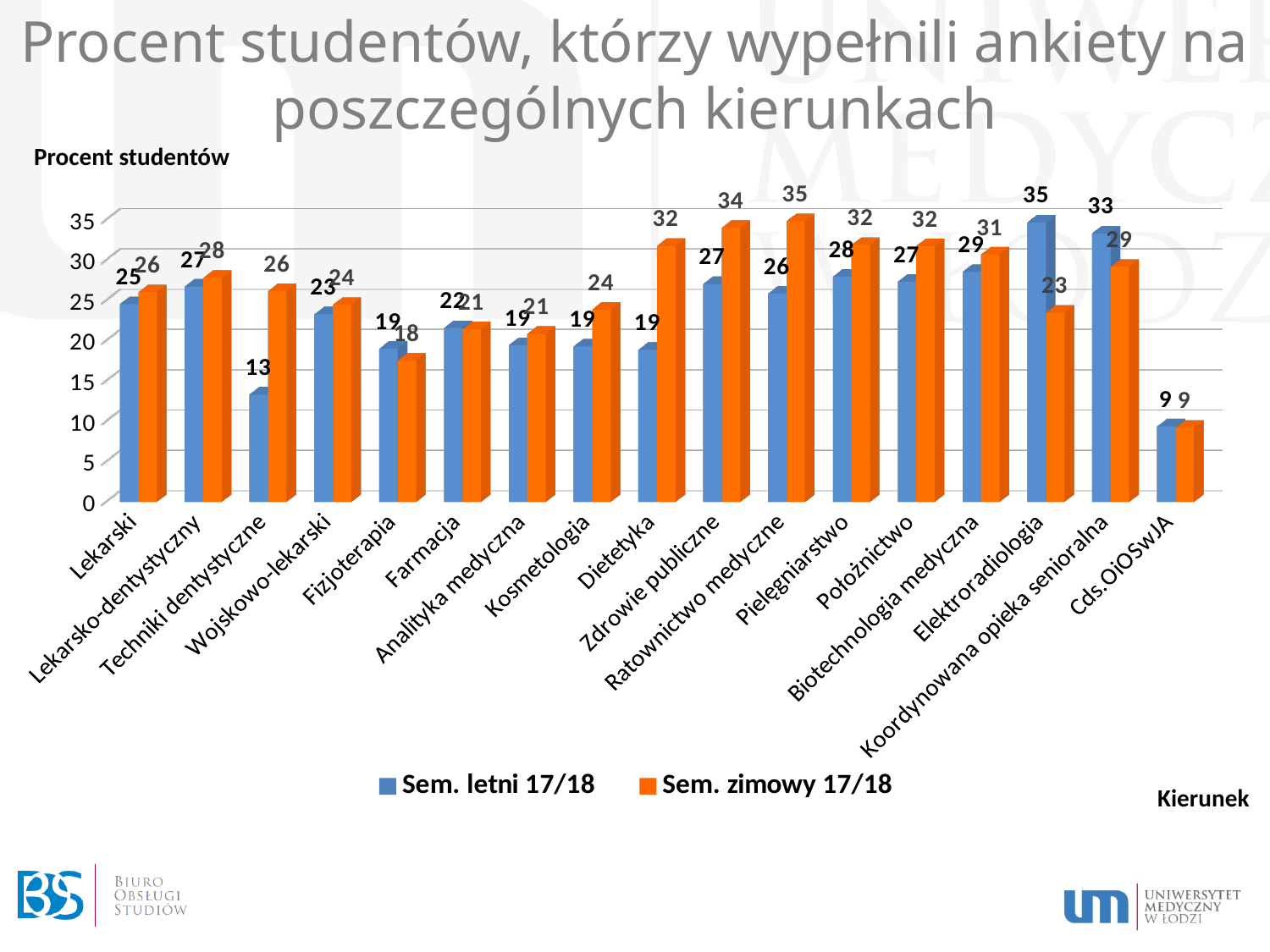
Which is larger for Koordynowana opieka senioralna: the Sem. letni 17/18 value or the Sem. zimowy 17/18 value? Sem. letni 17/18 What is the difference between the Sem. zimowy 17/18 and Sem. letni 17/18 values for Dietetyka? 13 Which category has the highest value in the Sem. letni 17/18 series? Elektroradiologia What is the value for Techniki dentystyczne in the Sem. letni 17/18 series? 13 How many categories (kierunki) are shown on the x axis? 17 Which category has the lowest value in the Sem. letni 17/18 series? Cds.OiOSwJA What is the value for Dietetyka in the Sem. zimowy 17/18 series? 32 How many series does the legend list? 2 Which category has the highest value in the Sem. zimowy 17/18 series? Ratownictwo medyczne What kind of chart is shown on the slide? Bar chart What is the difference between the Sem. zimowy 17/18 and Sem. letni 17/18 values for Techniki dentystyczne? 13 What is the value for Elektroradiologia in the Sem. zimowy 17/18 series? 23